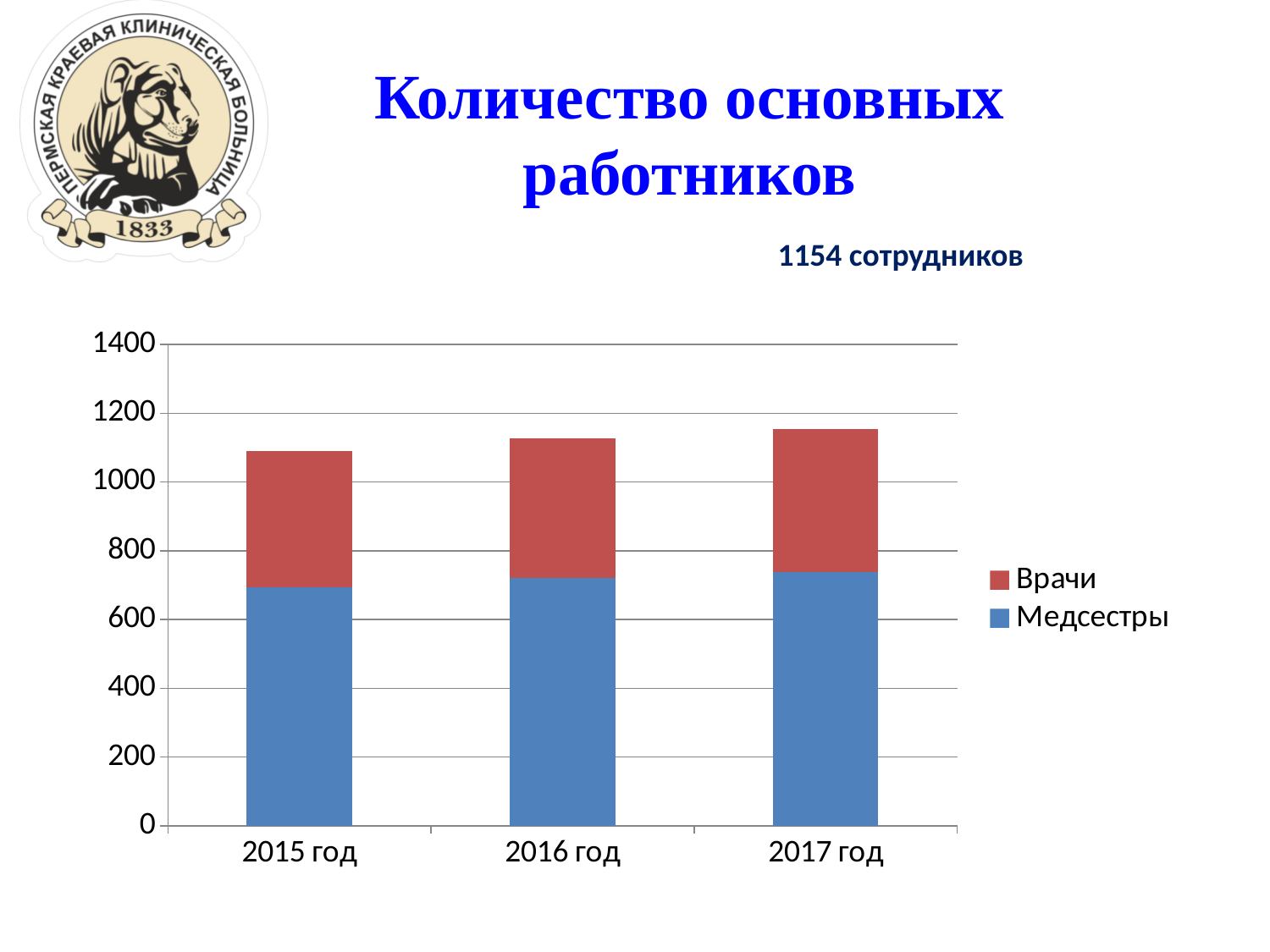
Is the total for 2015 год greater or less than 1000? greater How many series does the legend list? 2 Which colour represents Врачи in the legend? red Is the value for Медсестры in 2015 год greater or less than 600? greater Which year has the tallest stacked bar (largest total)? 2017 год How many years (categories) are shown on the x axis? 3 What kind of chart is shown on the slide? bar chart Is the value for Медсестры in 2017 год greater or less than 800? less Do the total bar heights rise or fall from 2015 год to 2017 год? rise What is the title of the chart on the slide? Количество основных работников Which year has the shortest stacked bar (smallest total)? 2015 год